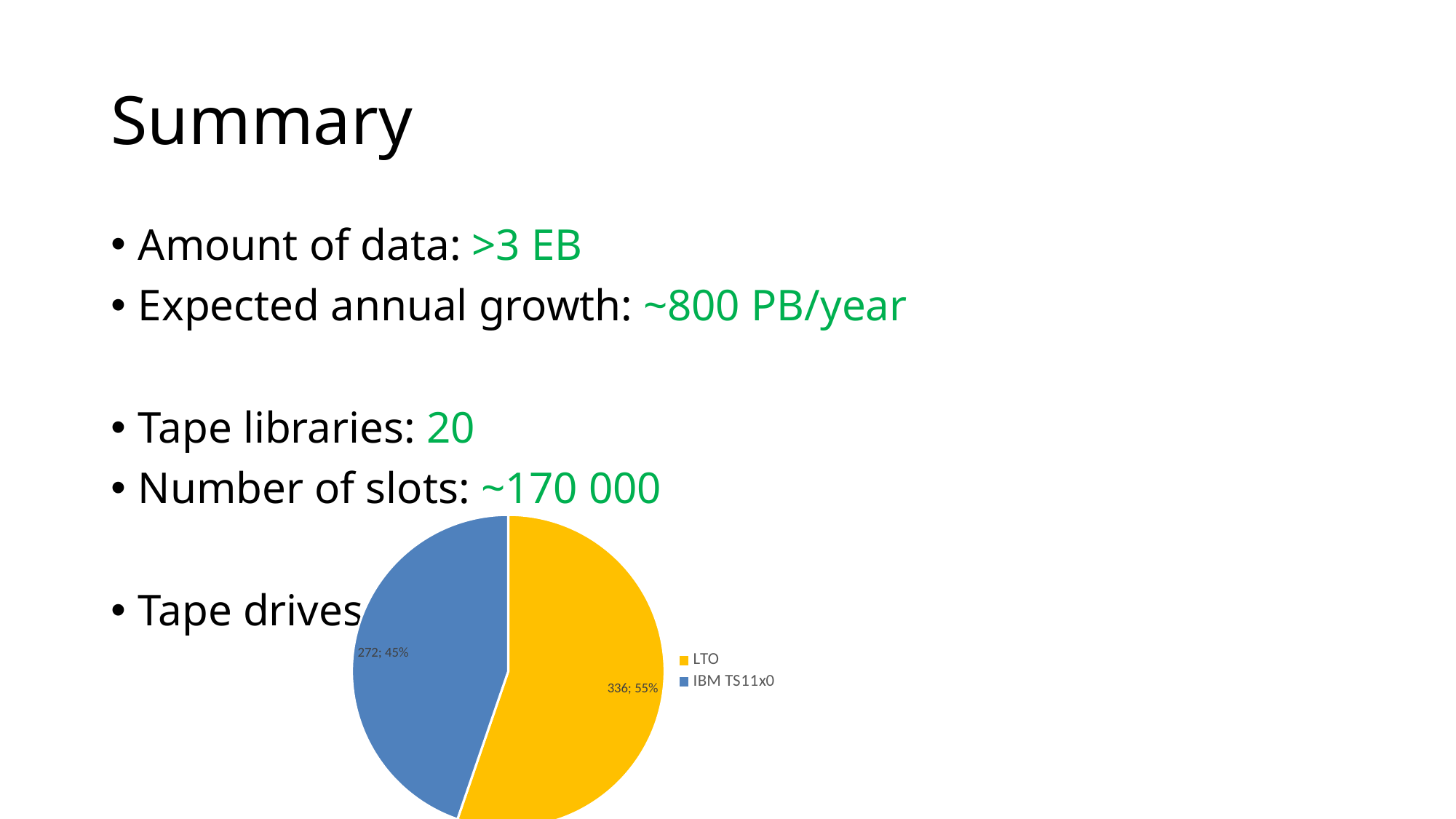
What colour is the LTO slice in the pie chart? yellow What kind of chart is shown on the slide? pie chart What share of the pie does the LTO slice represent? 55% How many categories does the pie chart show? 2 Which category has the smallest slice in the pie chart? IBM TS11x0 What share of the pie does the IBM TS11x0 slice represent? 45% How many tape drives are IBM TS11x0 according to the pie chart? 272 What is the total number of tape drives shown in the pie chart? 608 What is the difference between the number of LTO drives and IBM TS11x0 drives? 64 How many tape drives are LTO according to the pie chart? 336 Which is larger, the LTO slice or the IBM TS11x0 slice? LTO Which category has the largest slice in the pie chart? LTO